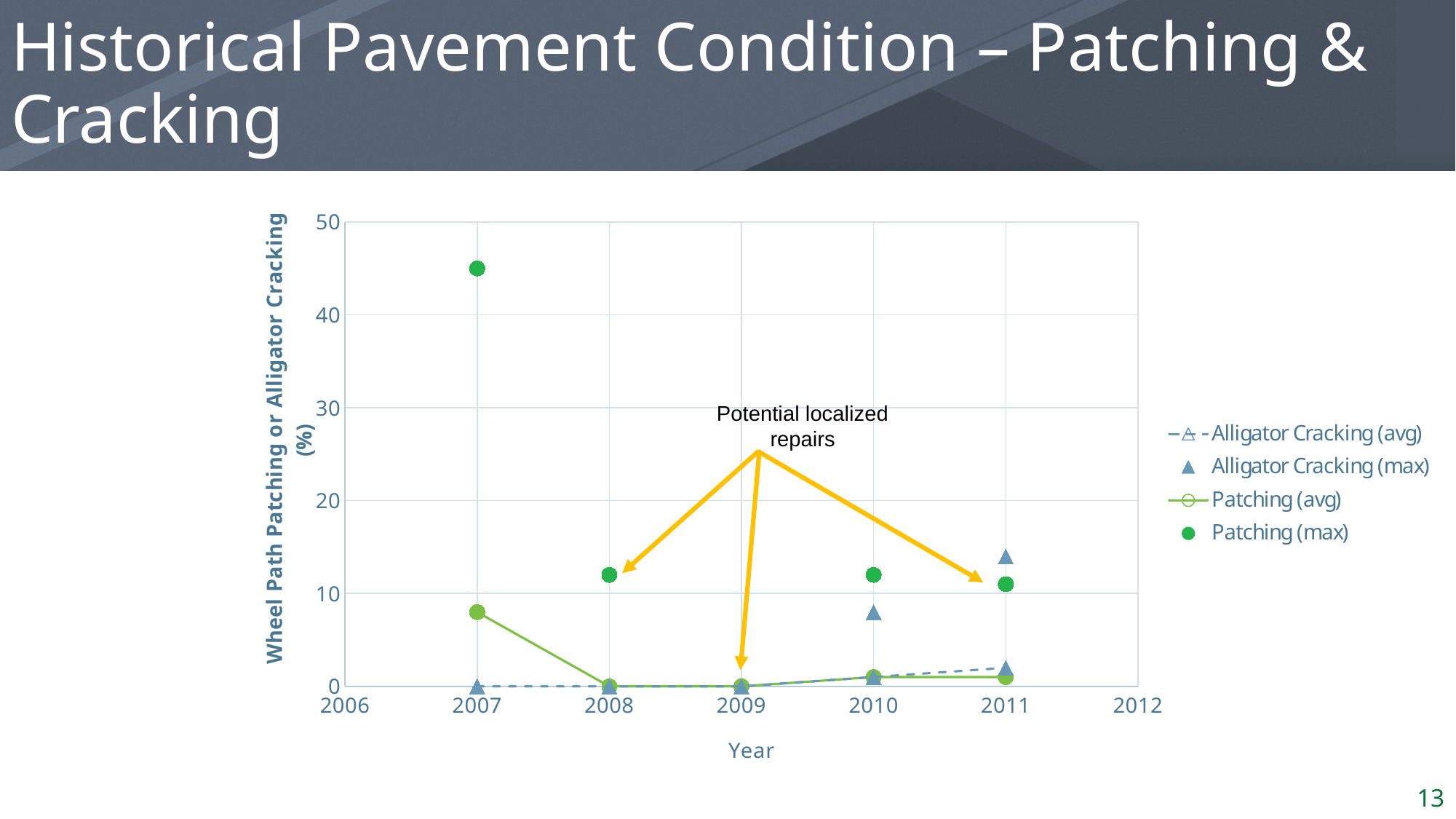
Is the Patching (max) value for 2008 greater or less than 20? less Which year has the larger Alligator Cracking (max) value, 2010 or 2011? 2011 What does the annotation with the arrows on the chart say? Potential localized repairs How many series does the legend list? 4 Is the Patching (avg) value for 2007 greater or less than 5? greater Does the Patching (avg) value rise or fall from 2007 to 2008? fall What is the title of the x axis? Year What kind of chart is shown on the slide? line chart Is the Alligator Cracking (max) value for 2010 greater or less than 10? less In which year is the Patching (max) value highest? 2007